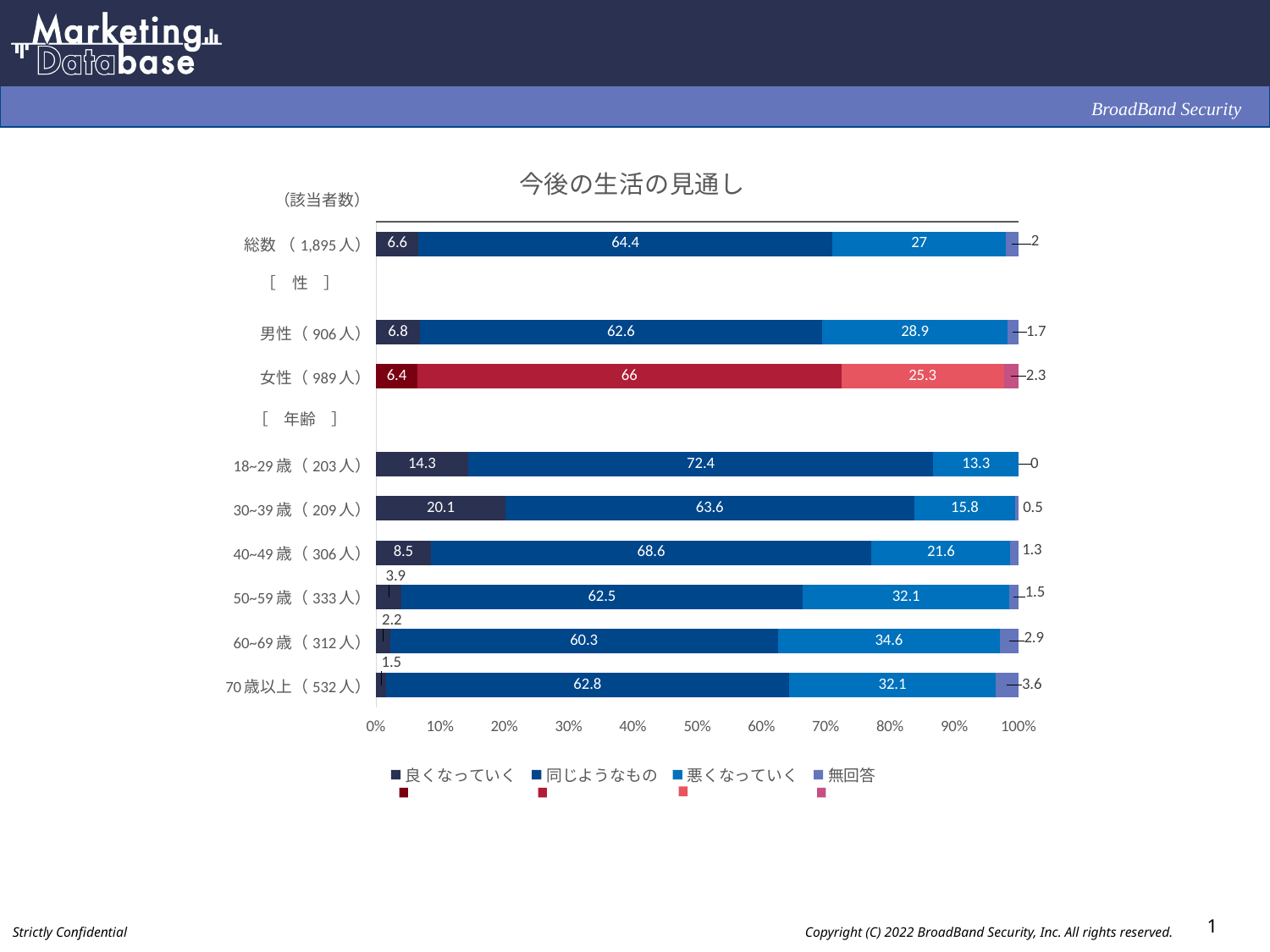
What is the value of 良くなっていく for 18~29歳? 14.3 How many categories (bars) are plotted in the chart? 9 What kind of chart is shown on the slide? Stacked bar chart What is the difference between the 悪くなっていく values for 男性 and 女性? 3.6 What is the value of 無回答 for 70歳以上? 3.6 How many named series does the legend list? 4 Which category has the highest value for 良くなっていく? 30~39歳 What is the title of the chart? 今後の生活の見通し What is the value of 悪くなっていく for 男性? 28.9 Which category has the lowest value for 良くなっていく? 70歳以上 What is the value of 同じようなもの for 総数? 64.4 Which has a larger 同じようなもの value, 18~29歳 or 60~69歳? 18~29歳